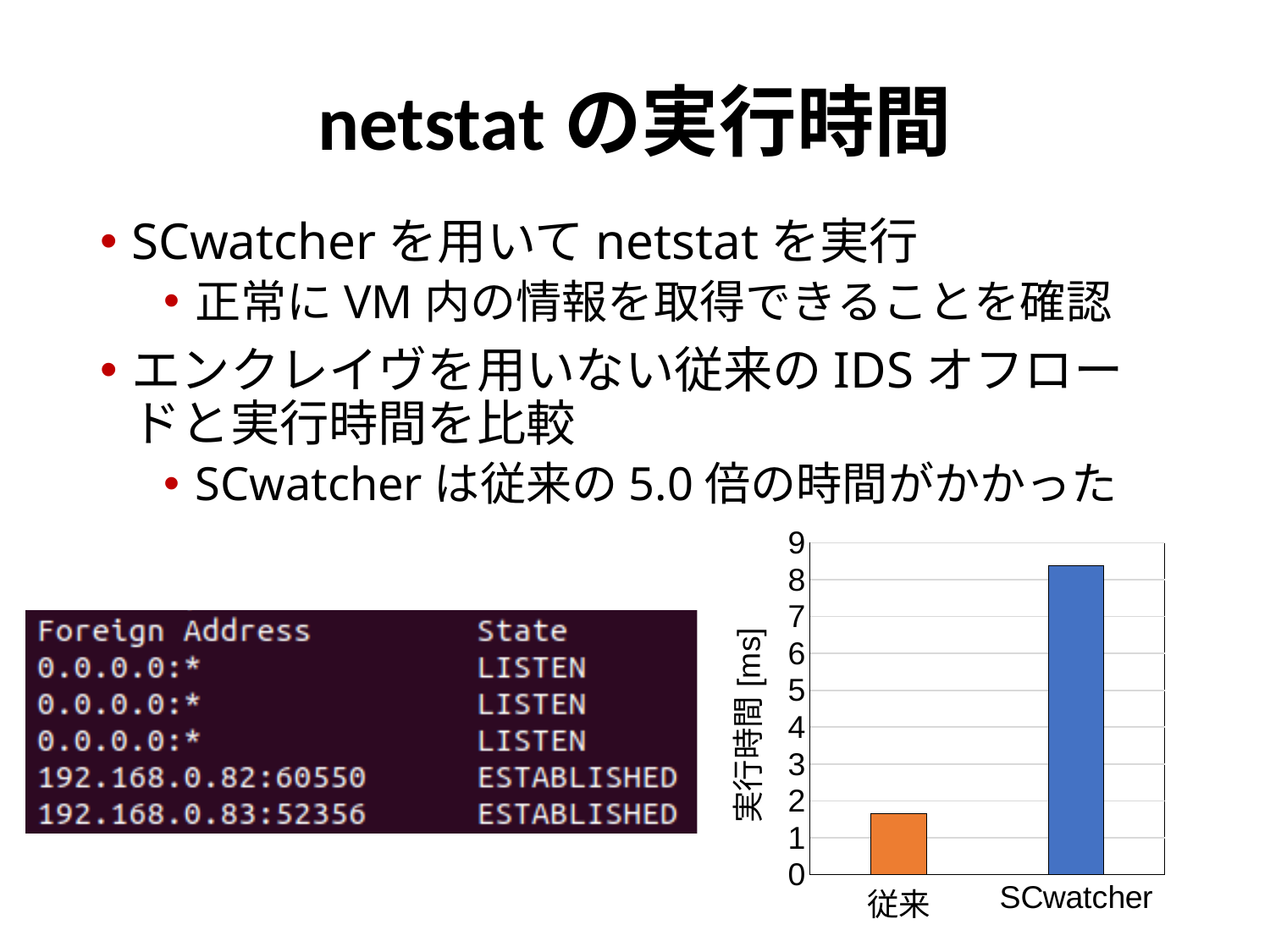
What kind of chart is shown on the slide? bar chart Is the value for SCwatcher greater or less than 9? less What is the maximum value shown on the vertical axis of the chart? 9 Is the value for 従来 greater or less than 1? greater Is the value for SCwatcher greater or less than 8? greater Which category has the lowest execution time in the chart? 従来 How many bars does the chart show? 2 What is the label of the vertical axis of the chart? 実行時間 [ms] Which has a larger value in the chart, 従来 or SCwatcher? SCwatcher Which category has the highest execution time in the chart? SCwatcher